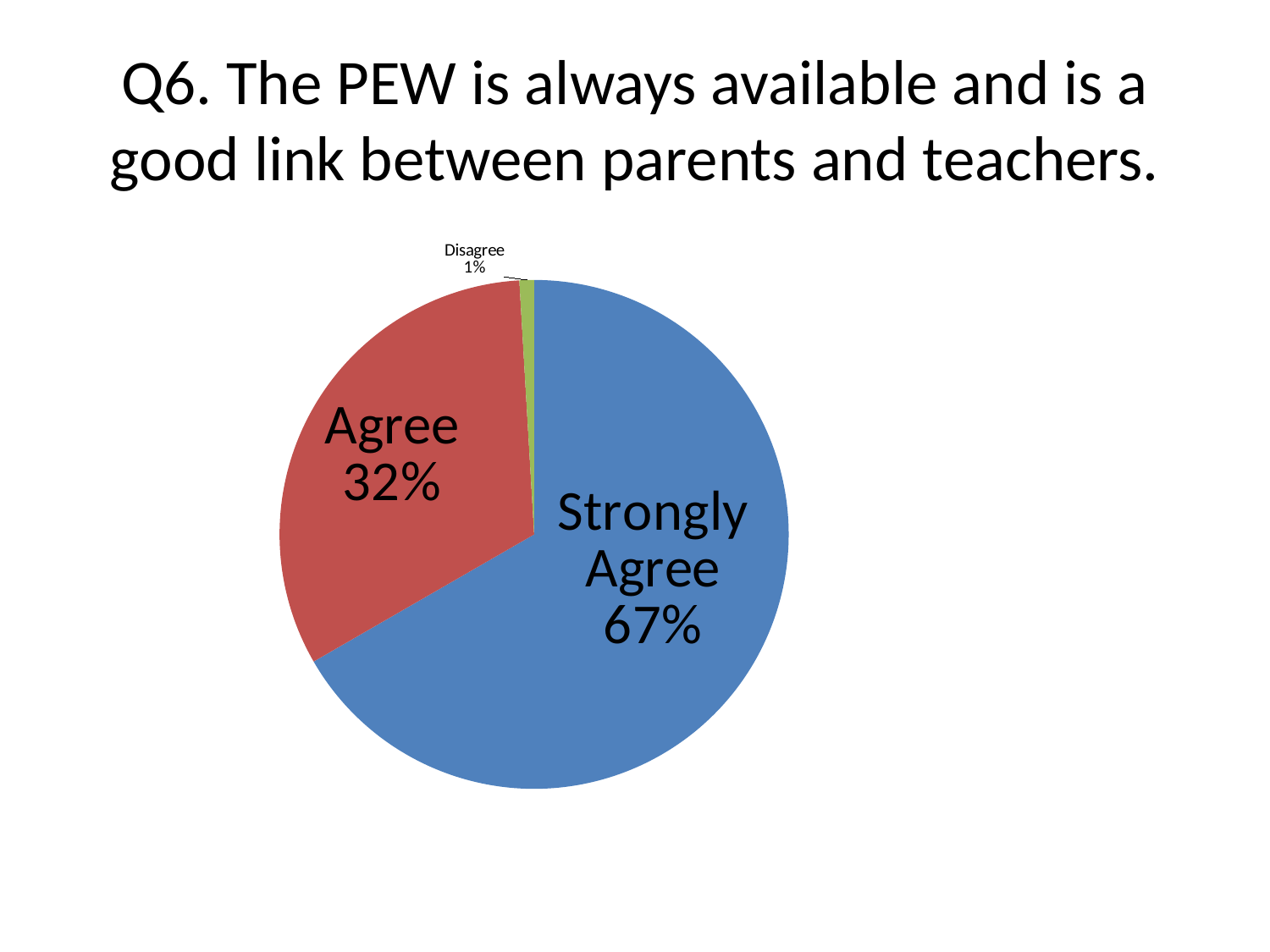
How many slices does the pie chart have? 3 Which slice of the pie is the smallest? Disagree What share of the pie is labelled Disagree? 1% What share of the pie is labelled Agree? 32% What colour is the Strongly Agree slice? blue What is the difference in percentage points between the Strongly Agree and Agree slices? 35 Which is larger, the Agree slice or the Disagree slice? Agree What is the title of the slide containing the pie chart? Q6. The PEW is always available and is a good link between parents and teachers. What share of the pie is labelled Strongly Agree? 67% Which slice of the pie is the largest? Strongly Agree What kind of chart is shown on the slide? pie chart What is the combined share of the Strongly Agree and Agree slices? 99%